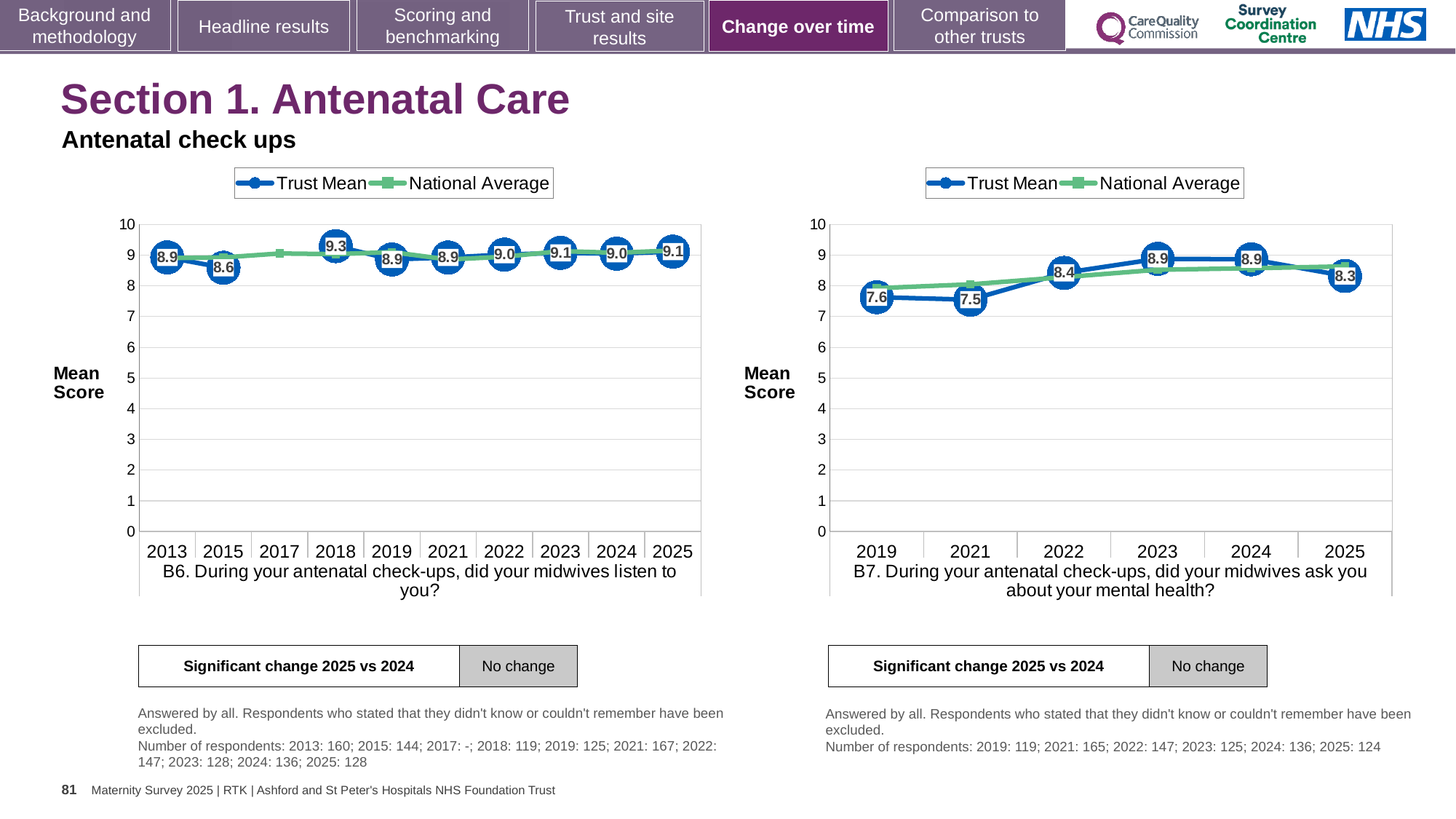
What type of chart is the left chart (B6)? Line chart In the right chart (B7), how many series does the legend list? 2 In the left chart (B6), which year has the highest Trust Mean score? 2018 In the right chart (B7), does the Trust Mean rise or fall from 2021 to 2023? Rise In the right chart (B7), which year has the lowest Trust Mean score? 2021 In the left chart (B6), which is larger, the Trust Mean for 2015 or for 2018? 2018 In the right chart (B7), what is the difference between the Trust Mean for 2023 and for 2019? 1.3 In the left chart (B6), what is the Trust Mean score for 2025? 9.1 In the right chart (B7), what is the Trust Mean score for 2022? 8.4 In the left chart (B6), which year has the lowest Trust Mean score? 2015 In the right chart (B7), how many years are shown on the x axis? 6 In the left chart (B6), what is the Trust Mean score for 2018? 9.3